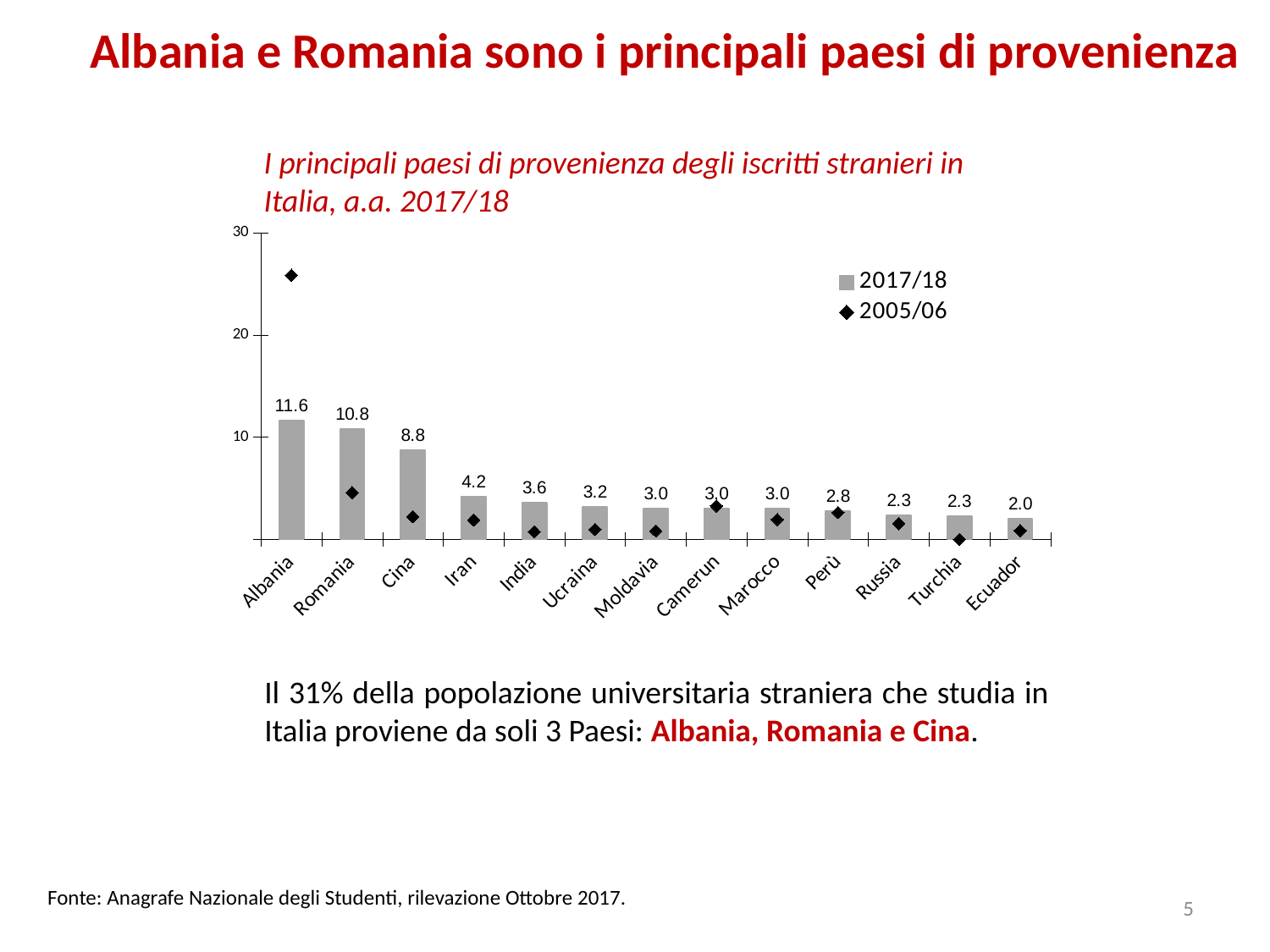
Is the 2005/06 value for Albania greater or less than 20? greater How many series does the legend list? 2 What is the difference between the 2017/18 values for Cina and Iran? 4.6 What is the 2017/18 value for Cina? 8.8 What is the 2017/18 value for Perù? 2.8 What is the difference between the 2017/18 values for Albania and Romania? 0.8 Do the 2017/18 values rise or fall from left to right along the x axis? fall How many countries are shown on the x axis? 13 Which country has the lowest 2017/18 value? Ecuador Which country has the highest 2017/18 value? Albania Which has the larger 2017/18 value, Iran or India? Iran What is the 2017/18 value for Albania? 11.6